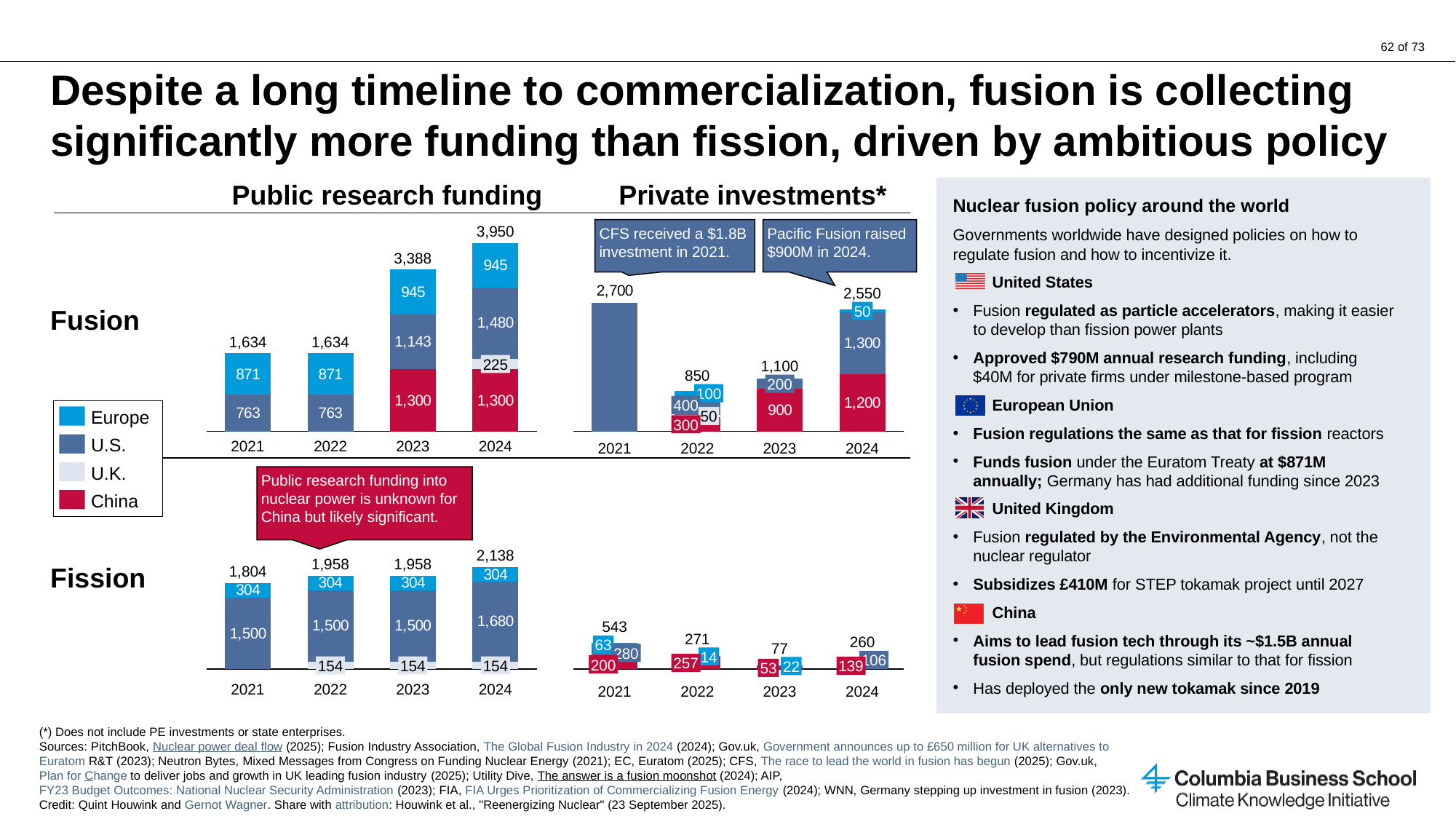
How many series does the legend list? 4 In the Fusion private investments chart, what is the China value for 2024? 1,200 In the Fusion public research funding chart, what is the difference between the U.S. value in 2024 and the U.S. value in 2023? 337 In the Fusion public research funding chart, what is the total for 2024? 3,950 In the Fusion private investments chart, which year has the highest total? 2021 In the Fission private investments chart, which year has the lowest total? 2023 In the Fission public research funding chart, which is larger: the U.S. value in 2024 or the U.S. value in 2023? 2024 In the Fission public research funding chart, what is the difference between the 2024 total and the 2021 total? 334 What kind of chart is the Fusion public research funding chart? Stacked bar chart How many years are shown on the x axis of the Fission private investments chart? 4 In the Fusion public research funding chart, what is the U.S. value for 2023? 1,143 In the Fusion public research funding chart, do the totals rise or fall from 2022 to 2024? Rise